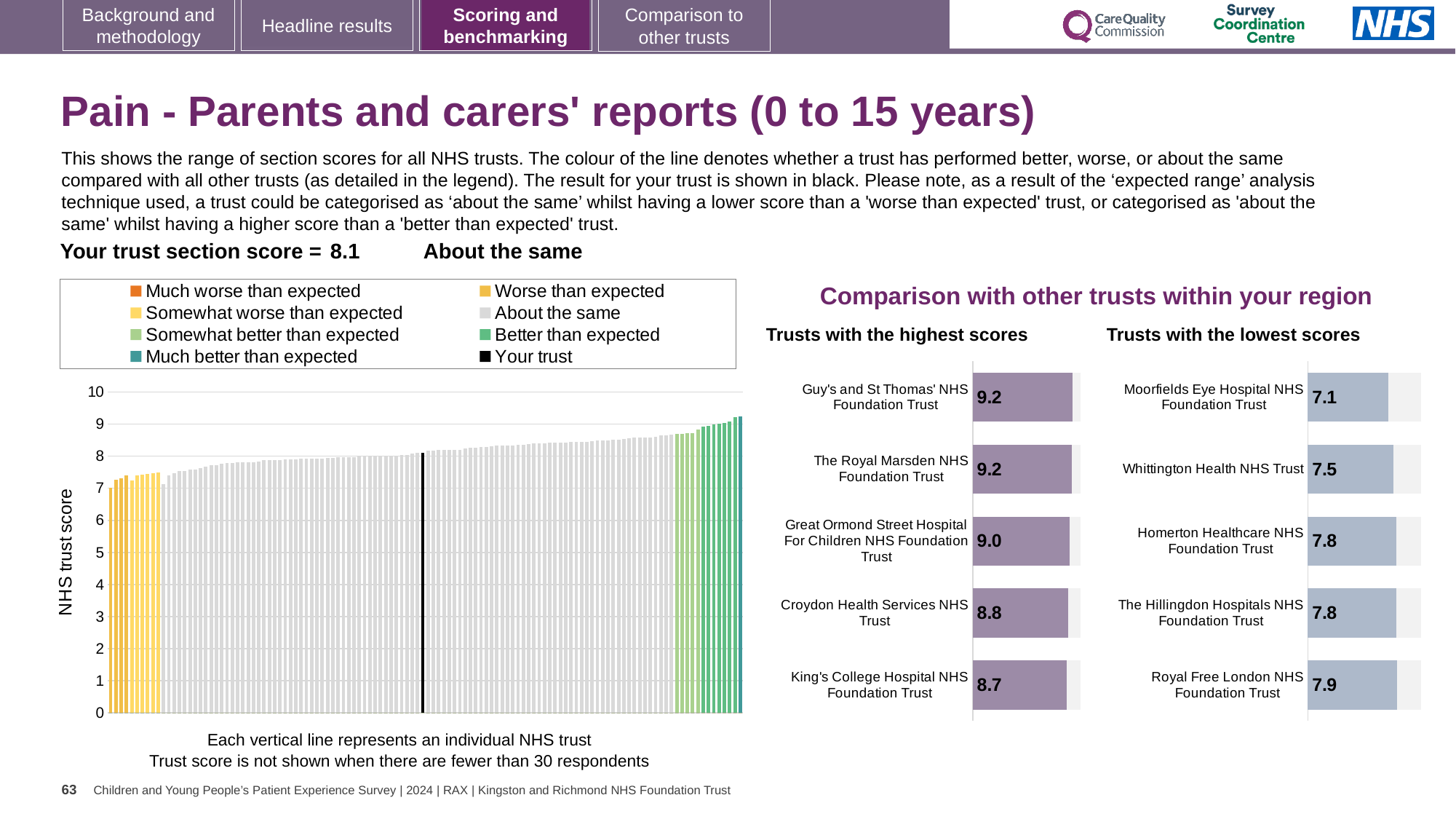
In the 'Trusts with the lowest scores' chart, which has the larger score: Whittington Health NHS Trust or Homerton Healthcare NHS Foundation Trust? Homerton Healthcare NHS Foundation Trust In the 'Trusts with the lowest scores' chart, which trust has the highest score? Royal Free London NHS Foundation Trust In the 'Trusts with the lowest scores' chart, what is the difference between the scores of Royal Free London NHS Foundation Trust and Moorfields Eye Hospital NHS Foundation Trust? 0.8 How many entries does the legend of the main chart on the left list? 8 In the 'Trusts with the highest scores' chart, what is the difference between the scores of Guy's and St Thomas' NHS Foundation Trust and King's College Hospital NHS Foundation Trust? 0.5 What kind of chart is the main chart on the left showing the range of section scores? Bar chart In the 'Trusts with the lowest scores' chart, what is the score for Moorfields Eye Hospital NHS Foundation Trust? 7.1 In the 'Trusts with the highest scores' chart, how many trusts are shown? 5 In the main chart on the left showing the range of section scores, what is the section score for your trust? 8.1 In the 'Trusts with the highest scores' chart, what is the score for Great Ormond Street Hospital For Children NHS Foundation Trust? 9.0 In the 'Trusts with the highest scores' chart, what is the score for Guy's and St Thomas' NHS Foundation Trust? 9.2 In the 'Trusts with the highest scores' chart, which trust has the lowest score? King's College Hospital NHS Foundation Trust